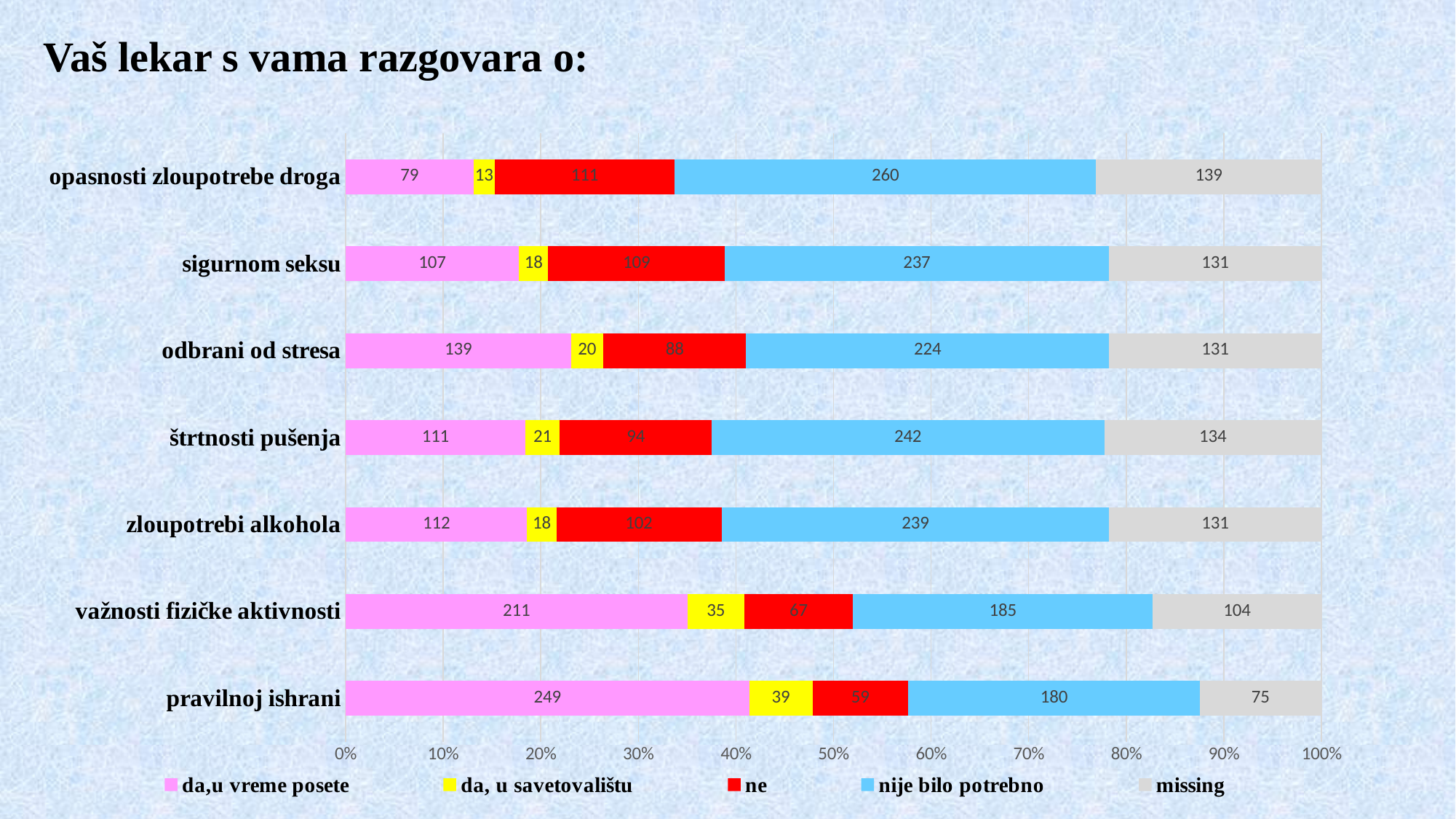
What is the "missing" value for "važnosti fizičke aktivnosti"? 104 What is the value of "da,u vreme posete" for "pravilnoj ishrani"? 249 What is the value of "nije bilo potrebno" for "opasnosti zloupotrebe droga"? 260 Which category has the lowest "missing" value? pravilnoj ishrani How many categories are shown on the chart? 7 What kind of chart is shown on the slide? Stacked bar chart Which is larger: the "da, u savetovalištu" value for "sigurnom seksu" or for "štrtnosti pušenja"? štrtnosti pušenja What is the difference between the "ne" values for "opasnosti zloupotrebe droga" and "pravilnoj ishrani"? 52 What is the value of "ne" for "odbrani od stresa"? 88 What is the total of all segments in the bar for "zloupotrebi alkohola"? 602 How many series does the legend list? 5 Which category has the highest value for "da,u vreme posete"? pravilnoj ishrani